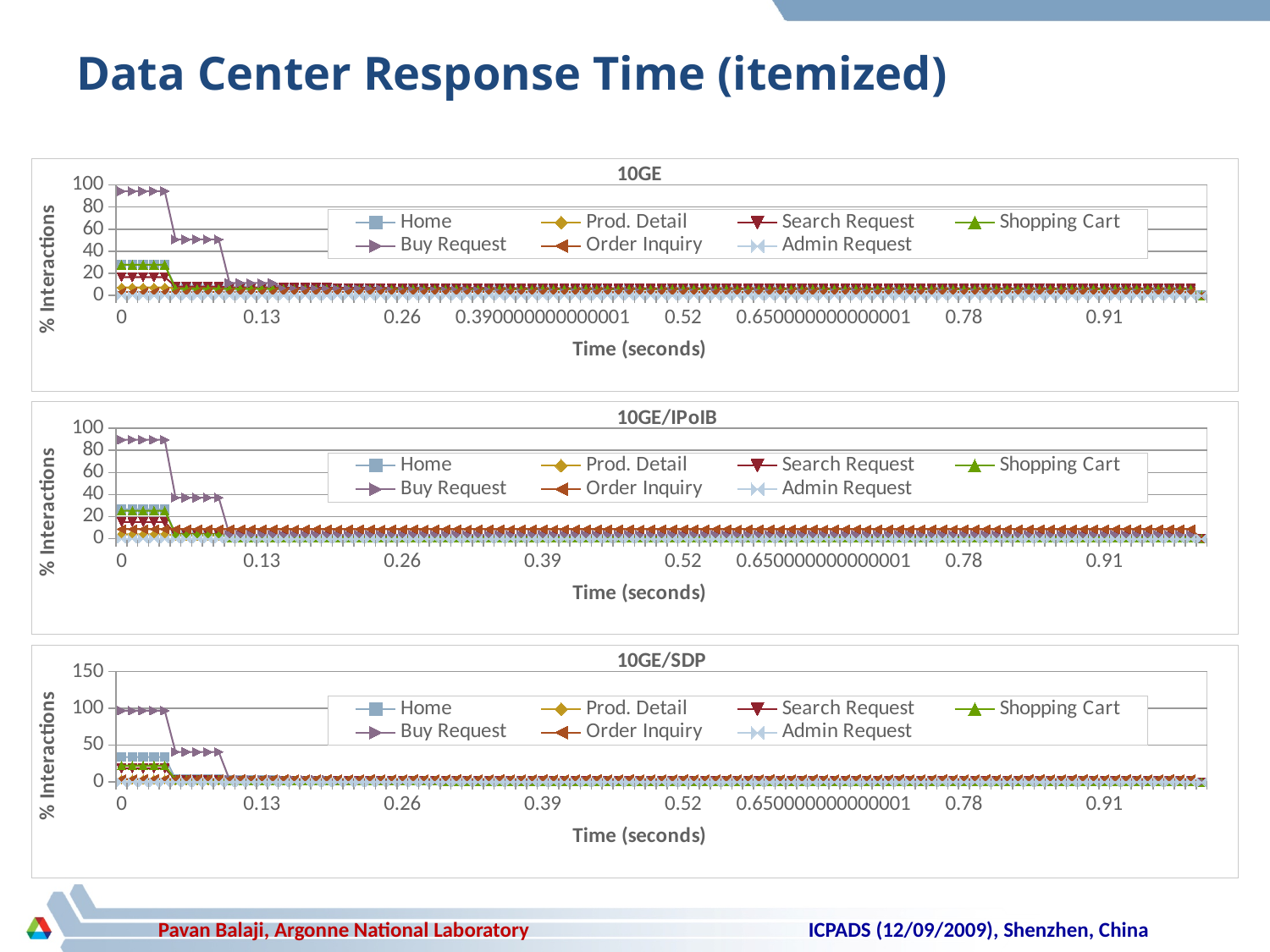
In the "10GE/SDP" chart, is the value for Buy Request at time 0 greater or less than 50? greater In the "10GE/SDP" chart, which series has the highest value at time 0? Buy Request What is the x-axis label of the "10GE" chart? Time (seconds) What is the y-axis label of the "10GE/SDP" chart? % Interactions In the "10GE/IPoIB" chart, does the Buy Request series rise or fall as time increases? fall How many series does the legend of the "10GE/IPoIB" chart list? 7 In the "10GE" chart, is the value for Home at time 0 greater or less than 20? greater What kind of chart is the "10GE" chart? line chart In the "10GE/IPoIB" chart, is the value for Buy Request at time 0 greater or less than 80? greater In the "10GE" chart, which series has the highest value at time 0? Buy Request In the "10GE" chart, at time 0, which is larger: Buy Request or Home? Buy Request